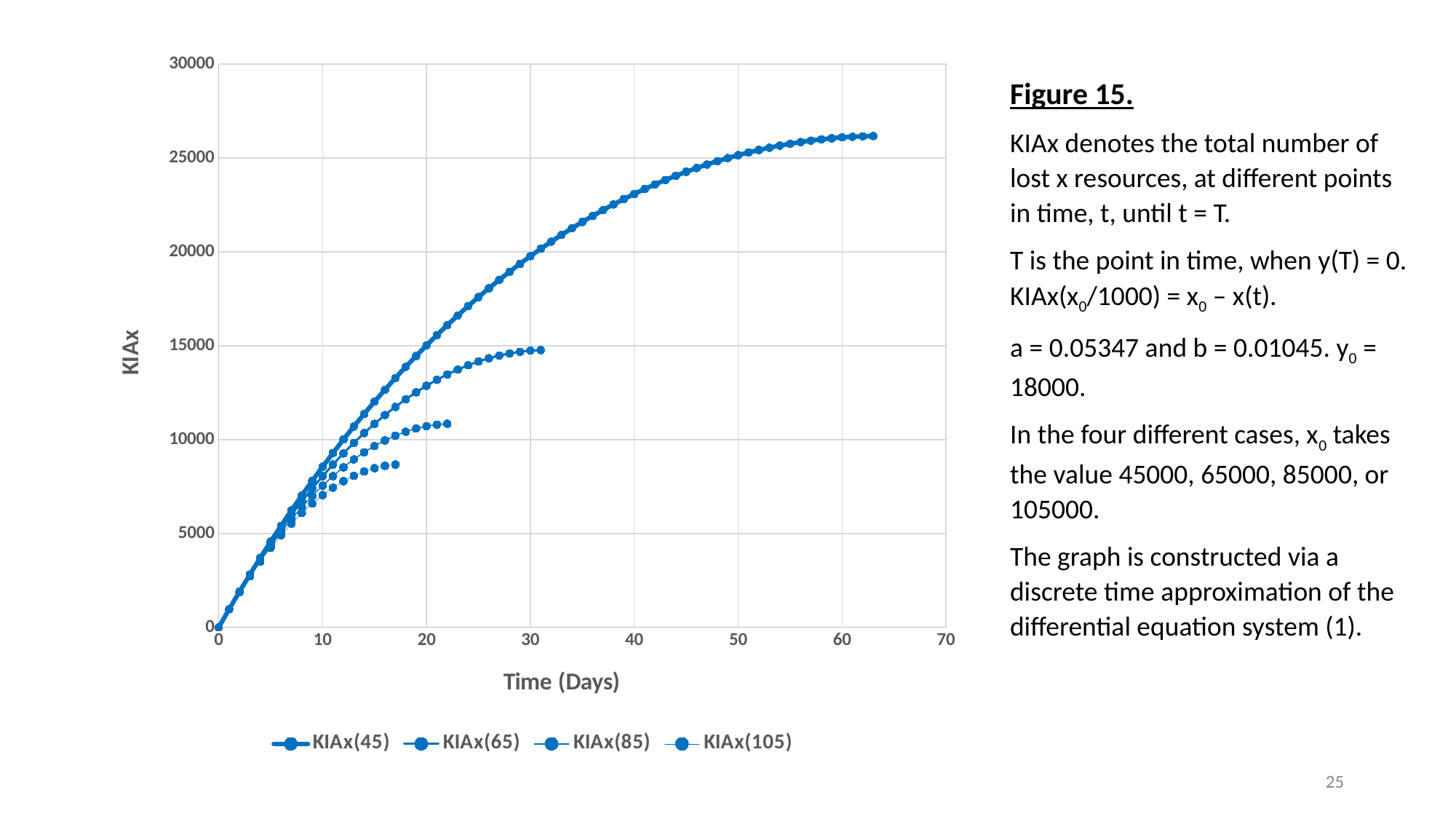
What is the value of the curves at time 0? 0 What is the title of the x axis? Time (Days) Is the final value of the second-highest curve greater or less than 10000? greater Does the longest curve extend to a time greater or less than 60 days? greater Do the plotted values rise or fall as time increases along the x axis? rise What kind of chart is shown on the slide? line chart Is the final value of the highest curve greater or less than 25000? greater How many series does the legend list? 4 What is the title of the y axis? KIAx